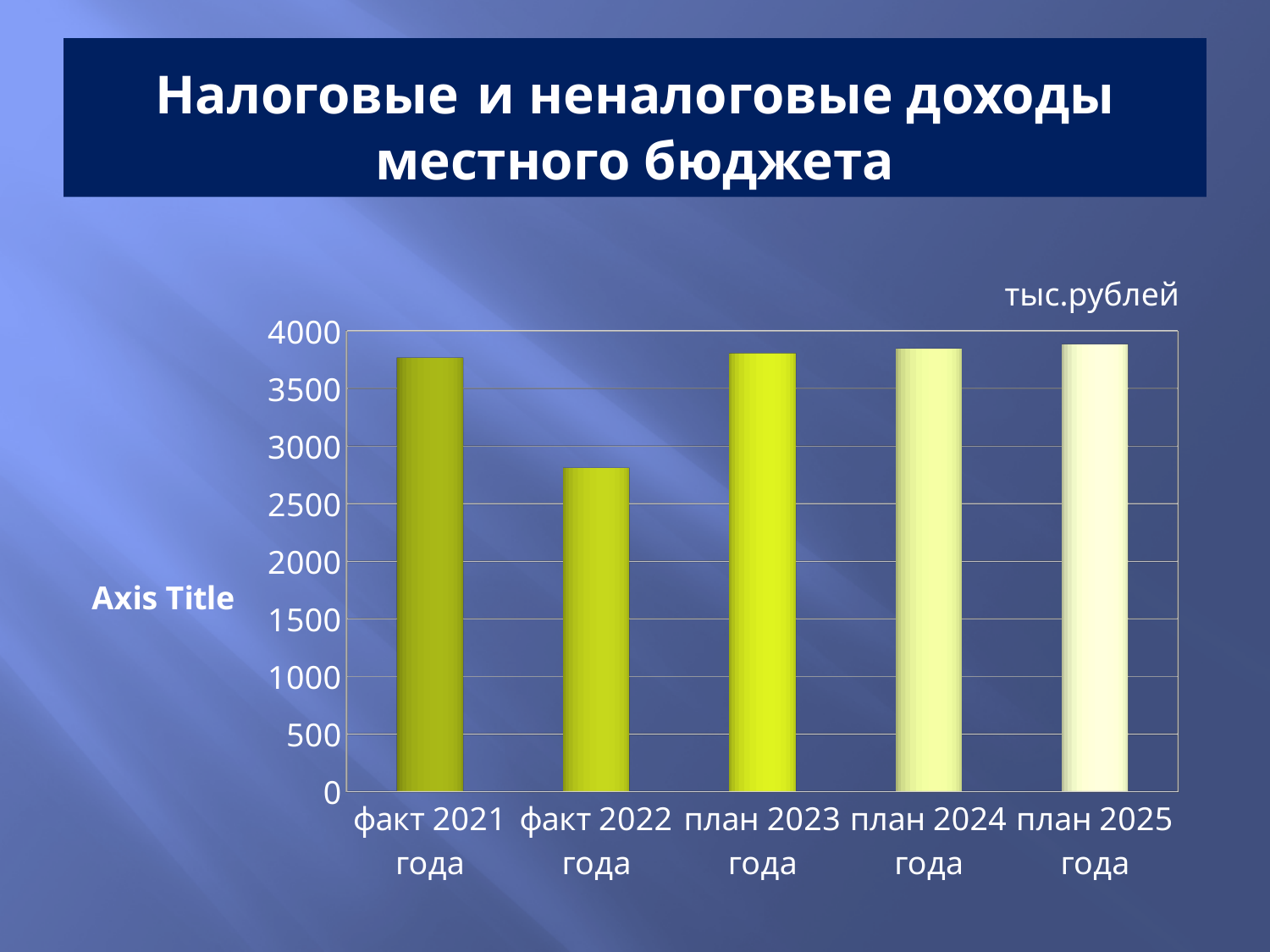
Is the value for план 2023 года greater or less than 3500? greater From факт 2022 года to план 2025 года, do the values rise or fall? rise Is the value for факт 2022 года greater or less than 3000? less Is the value for факт 2022 года greater or less than 2500? greater How many categories are shown on the x axis of the chart? 5 Which is larger, the value for факт 2021 года or the value for факт 2022 года? факт 2021 года What unit is indicated above the chart? тыс.рублей Which is larger, the value for факт 2022 года or the value for план 2024 года? план 2024 года Which category has the lowest value in the chart? факт 2022 года What kind of chart is shown on the slide? bar chart